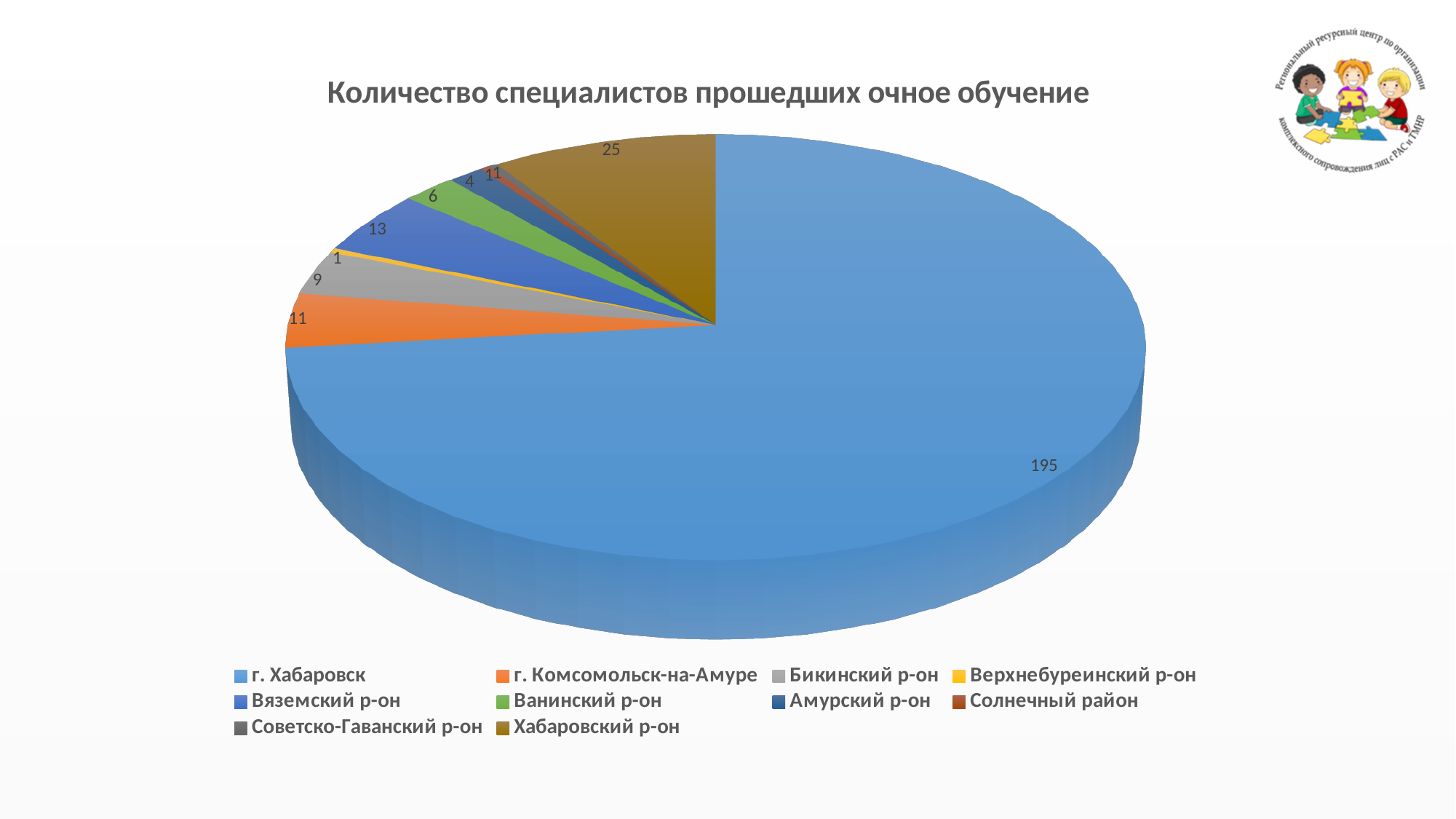
What is the value for Вяземский р-он? 13 What is the value for Ванинский р-он? 6 What is the value for Бикинский р-он? 9 What is the value for г. Комсомольск-на-Амуре? 11 What is the title of the chart? Количество специалистов прошедших очное обучение What is the difference between the values for Хабаровский р-он and Вяземский р-он? 12 Which is larger, the value for г. Комсомольск-на-Амуре or the value for Бикинский р-он? г. Комсомольск-на-Амуре What is the value for г. Хабаровск? 195 What is the value for Хабаровский р-он? 25 How many categories does the legend list? 10 What kind of chart is shown on the slide? pie chart Which category has the largest slice of the pie? г. Хабаровск